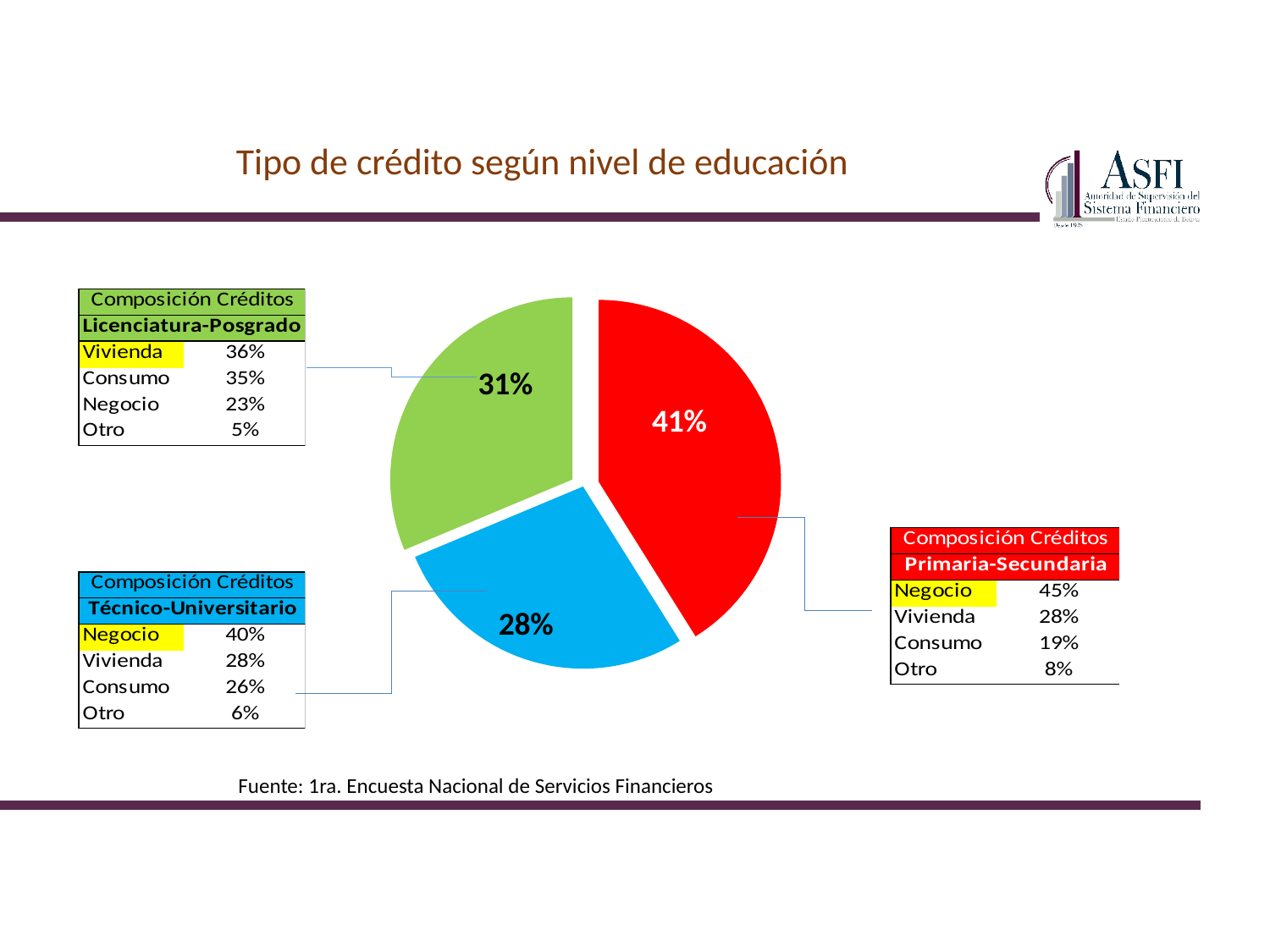
What kind of chart is shown on the slide? pie chart Which education level table is connected to the red slice of the pie chart? Primaria-Secundaria What share does the red slice of the pie chart represent? 41% How many slices does the pie chart have? 3 Which slice of the pie chart is the smallest? the blue slice (28%) In the Primaria-Secundaria table linked to the pie chart, what percentage is shown for Negocio? 45% Which slice of the pie chart is the largest? the red slice (41%) In the Licenciatura-Posgrado table linked to the pie chart, what percentage is shown for Vivienda? 36% What share does the blue slice of the pie chart represent? 28% Which is larger in the pie chart, the green slice or the blue slice? the green slice What share does the green slice of the pie chart represent? 31% What is the difference in percentage points between the largest slice (41%) and the smallest slice (28%) of the pie chart? 13 percentage points